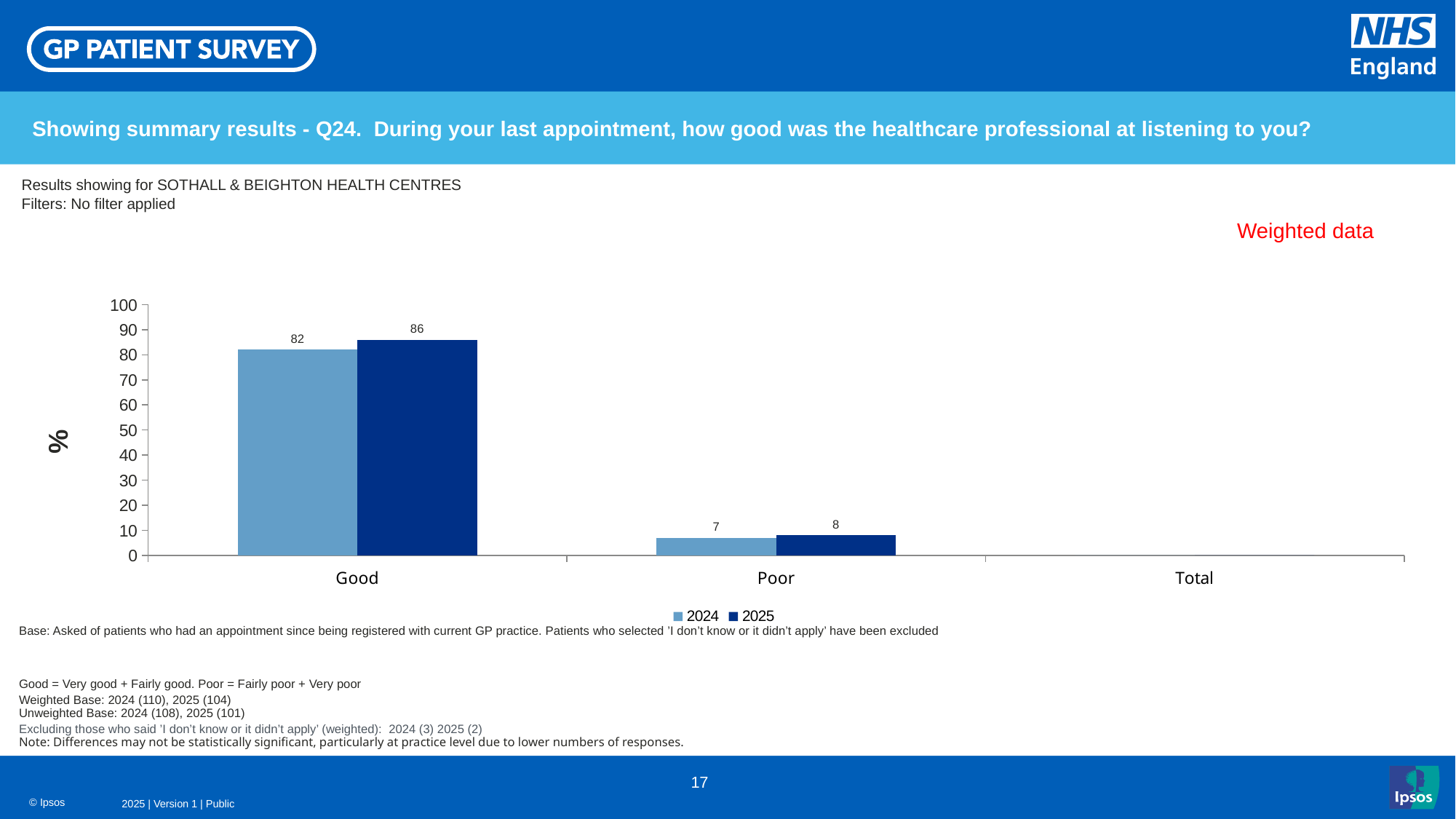
What label is shown on the vertical axis? % Which category has the highest value for 2025? Good Is the 2025 value for Good greater or less than 80? greater What is the value for Good in 2024? 82 What is the value for Good in 2025? 86 How many series does the legend list? 2 What is the difference between the 2025 and 2024 values for Good? 4 What is the value for Poor in 2025? 8 What is the value for Poor in 2024? 7 Which is larger, the 2024 value for Good or the 2025 value for Good? 2025 What kind of chart is shown on the slide? Bar chart What is the difference between the 2024 values for Good and Poor? 75